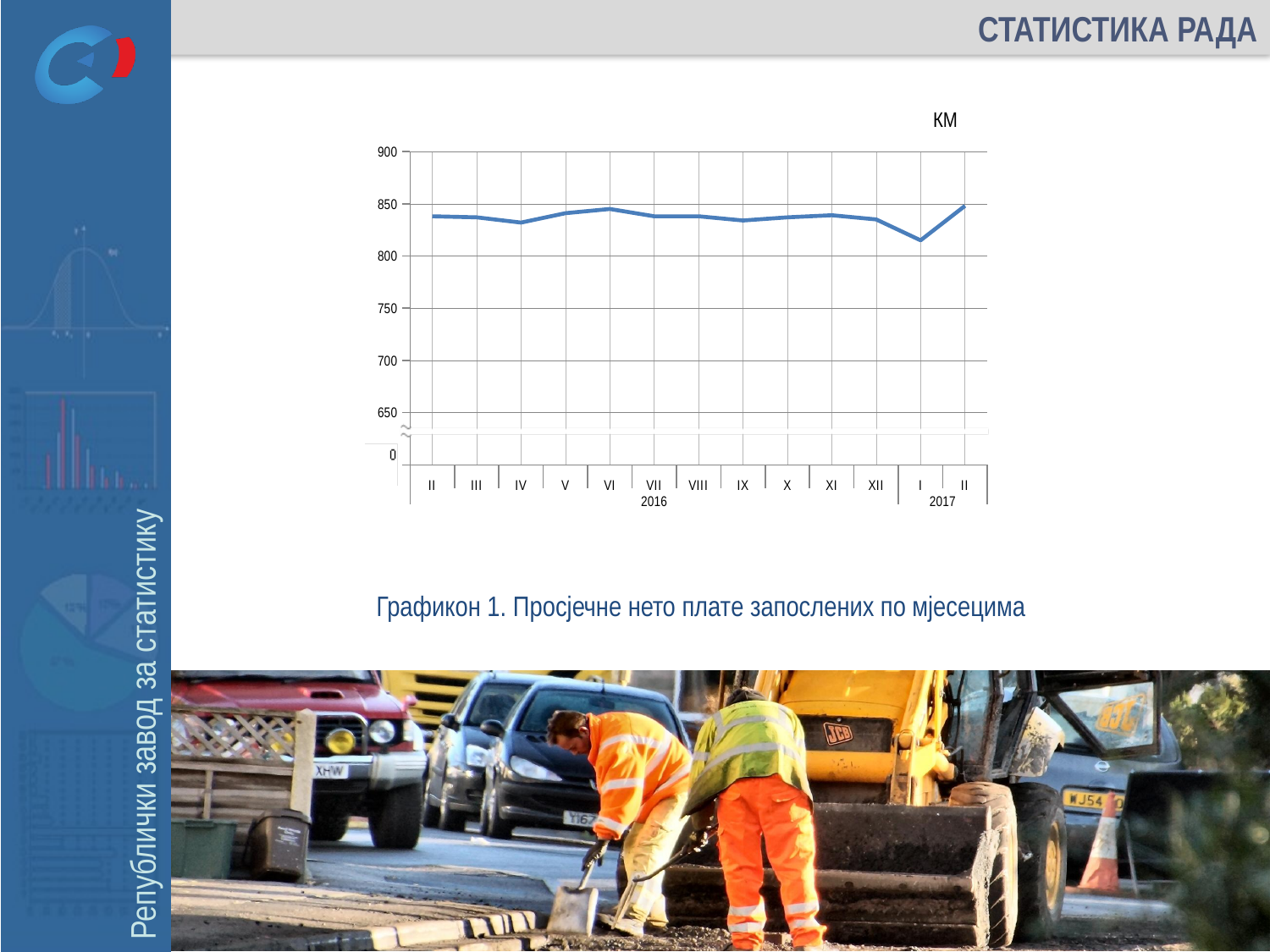
Is the value for VI 2016 greater or less than 800? greater Is the value for II 2016 greater or less than 850? less What unit is shown above the chart's vertical axis? КМ What kind of chart is shown on the slide? line chart Does the value rise or fall from XII 2016 to I 2017? fall Which month has the lowest value on the chart? I 2017 Which is larger, the value for VI 2016 or the value for I 2017? VI 2016 Does the value rise or fall from I 2017 to II 2017? rise Is the value for I 2017 greater or less than 850? less How many monthly data points are plotted on the chart? 13 What is the title of the chart on the slide? Графикон 1. Просјечне нето плате запослених по мјесецима